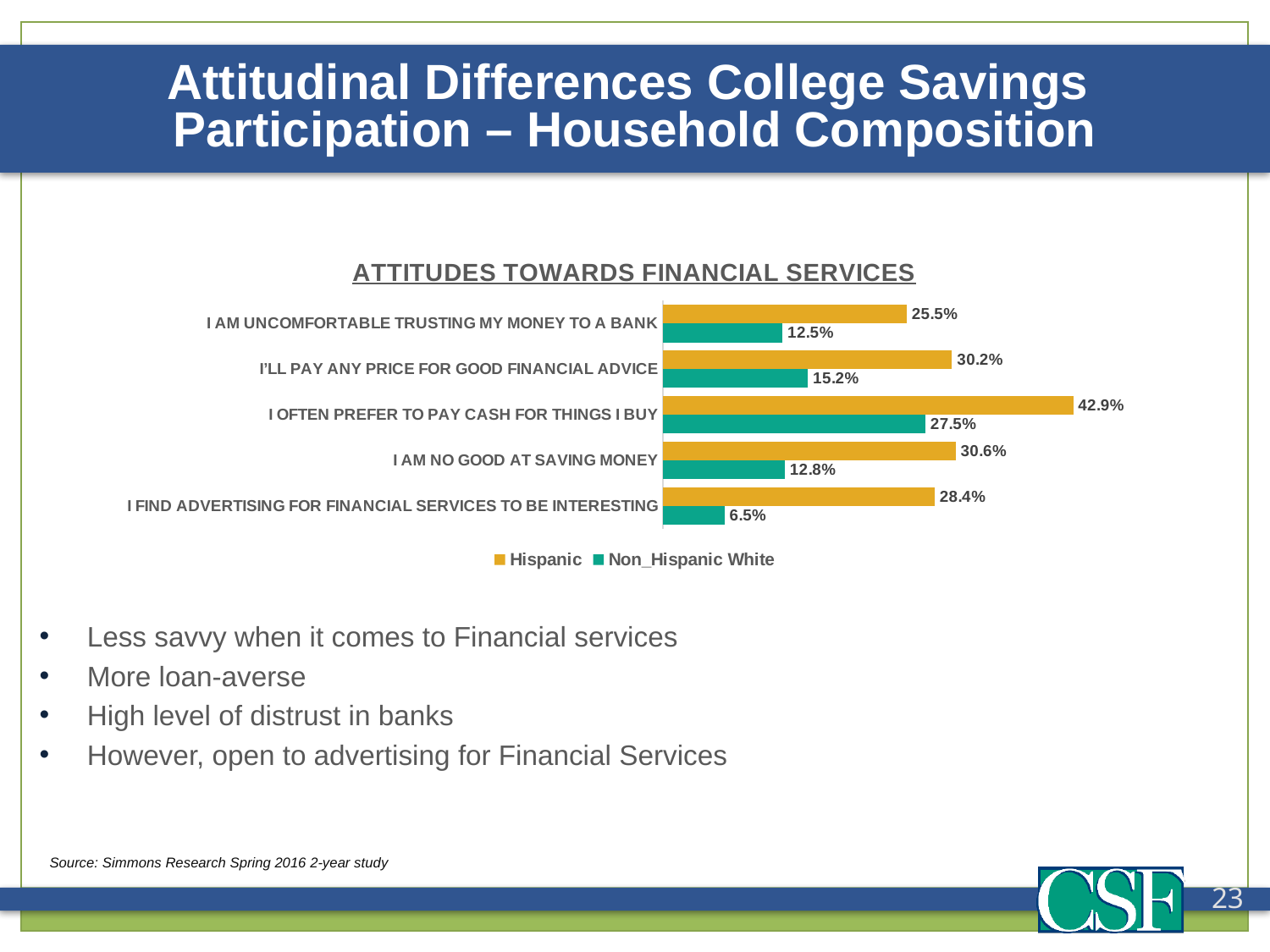
What is the title of the chart? ATTITUDES TOWARDS FINANCIAL SERVICES How many series does the legend list? 2 Which colour represents the Hispanic series in the chart? Yellow/gold Which attitude statement has the lowest Non_Hispanic White value? I find advertising for financial services to be interesting Which is larger: the Hispanic value for "I am uncomfortable trusting my money to a bank" or the Hispanic value for "I find advertising for financial services to be interesting"? I find advertising for financial services to be interesting What is the Hispanic value for "I often prefer to pay cash for things I buy"? 42.9% How many attitude statements are shown in the chart? 5 What is the Non_Hispanic White value for "I'll pay any price for good financial advice"? 15.2% What kind of chart is shown on the slide? Bar chart Which attitude statement has the highest Hispanic value? I often prefer to pay cash for things I buy What is the difference between the Hispanic and Non_Hispanic White values for "I am no good at saving money"? 17.8% What is the Non_Hispanic White value for "I find advertising for financial services to be interesting"? 6.5%